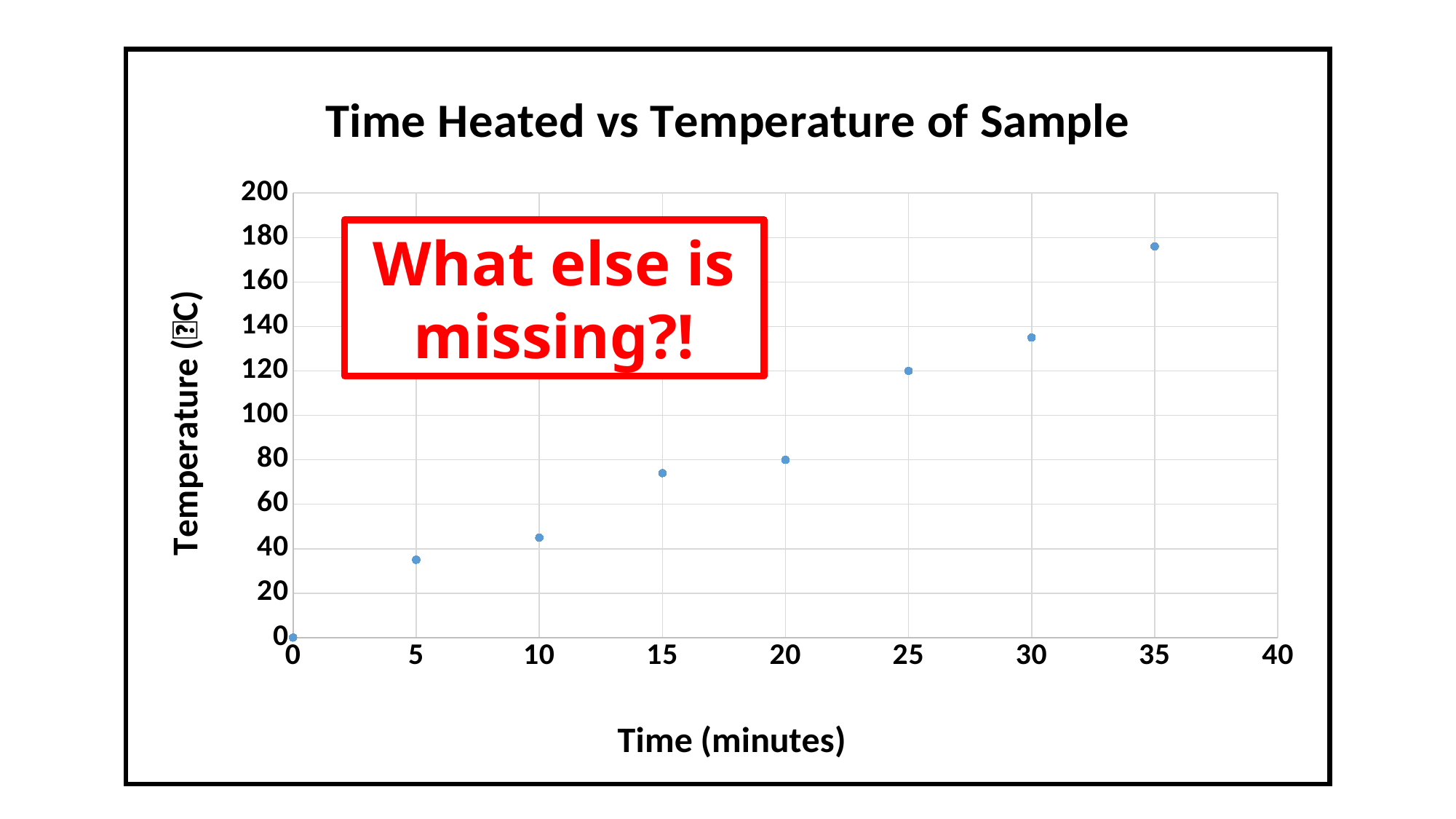
At which time is the temperature highest? 35 minutes What is the temperature at 0 minutes? 0 Is the temperature at 35 minutes greater or less than 160? greater What is the temperature at 20 minutes? 80 Which has a higher temperature, 15 minutes or 25 minutes? 25 minutes What is the title of the chart? Time Heated vs Temperature of Sample Is the temperature at 15 minutes greater or less than 80? less What type of chart is shown on the slide? scatter chart At which time is the temperature lowest? 0 minutes Does the temperature rise or fall as time increases? rise What is the temperature at 25 minutes? 120 How many data points are plotted on the chart? 8